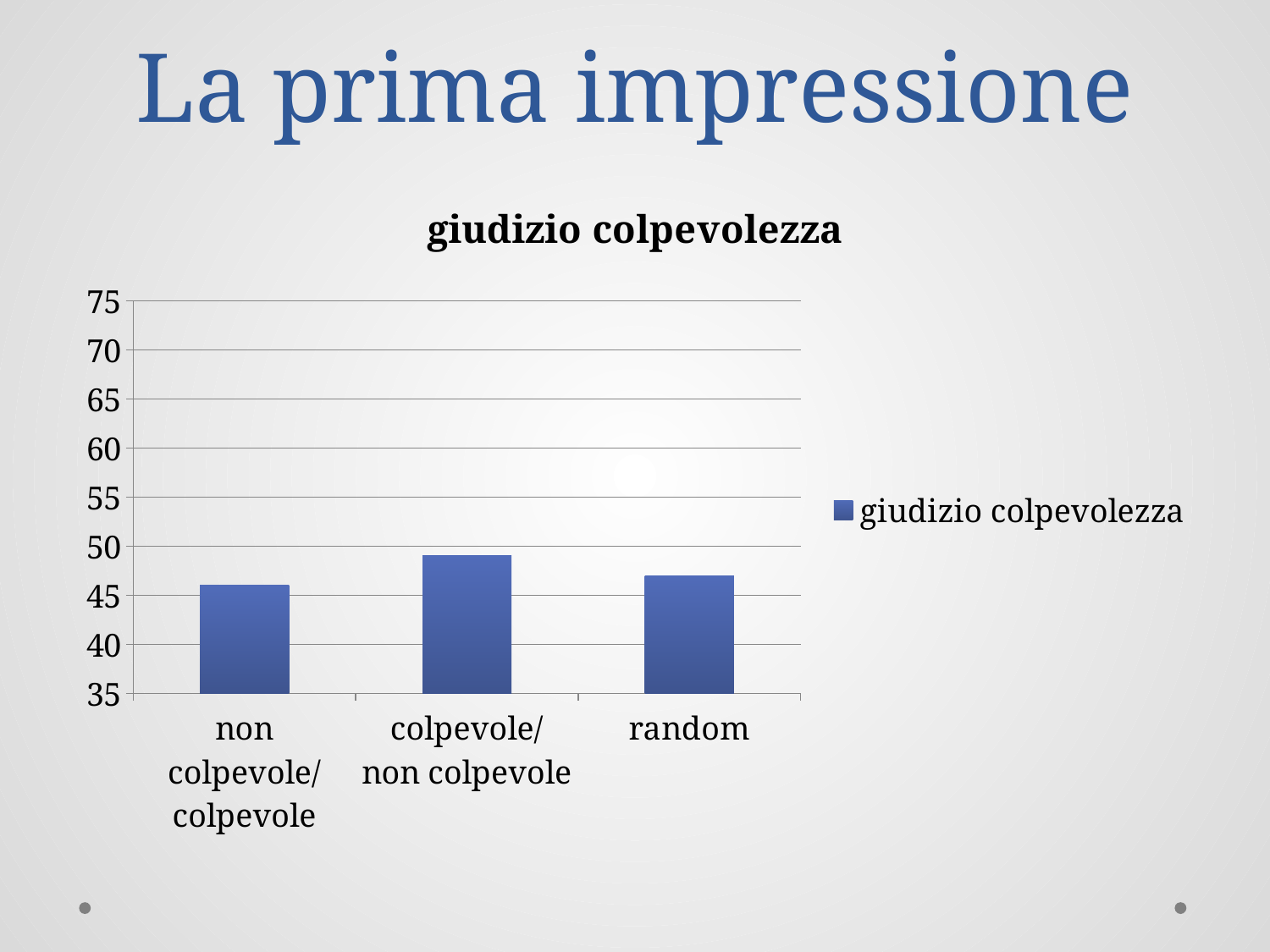
What is the title of the chart? giudizio colpevolezza Which is larger, the value for non colpevole/colpevole or the value for colpevole/non colpevole? colpevole/non colpevole What kind of chart is shown on the slide? bar chart What is the name of the series shown in the chart legend? giudizio colpevolezza How many categories are shown on the x axis of the chart? 3 Is the value for random greater or less than 50? less Is the value for random greater or less than 45? greater Which is larger, the value for colpevole/non colpevole or the value for random? colpevole/non colpevole Is the value for colpevole/non colpevole greater or less than 55? less How many series does the chart legend list? 1 Which category has the highest bar in the chart? colpevole/non colpevole